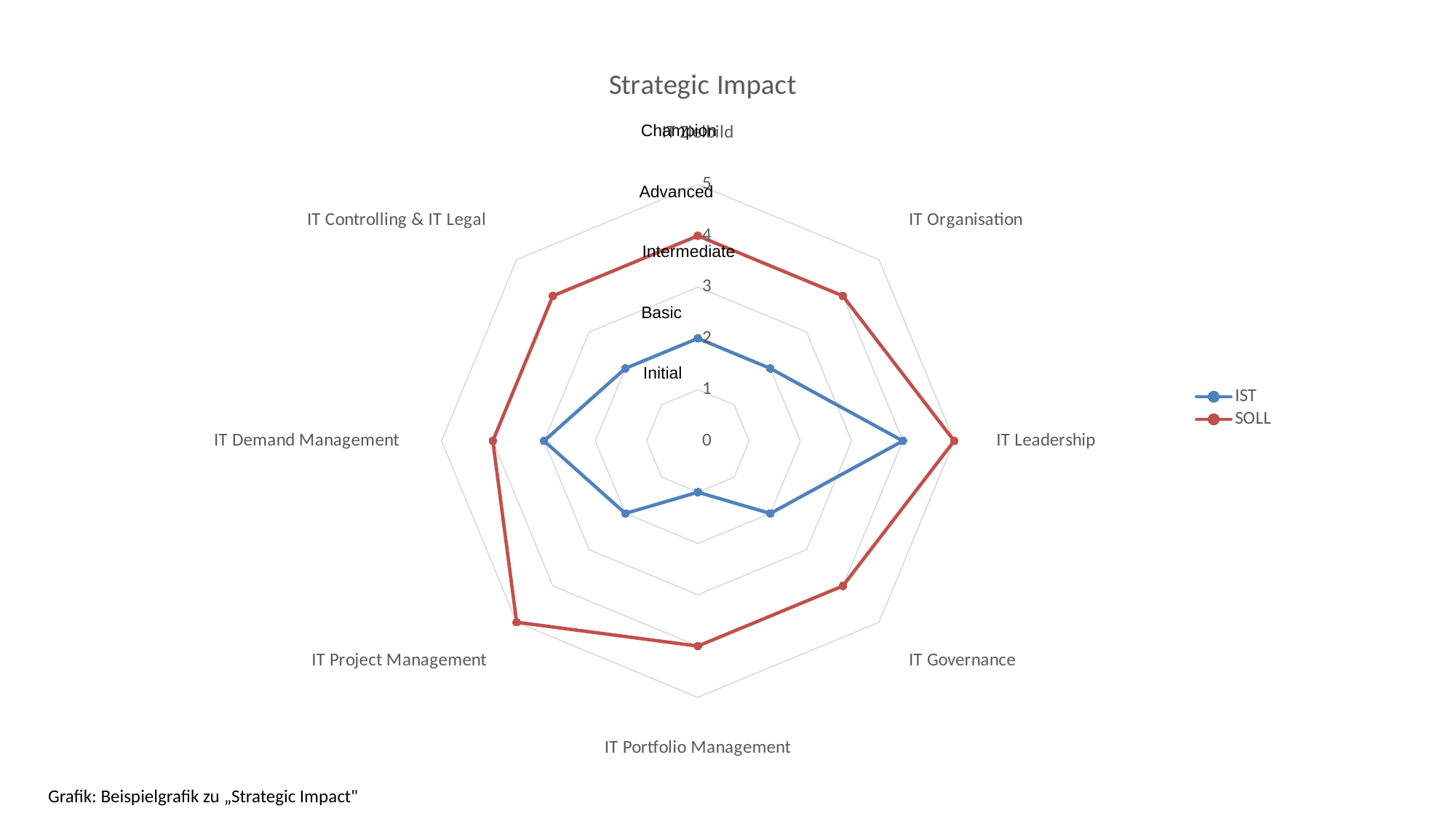
How many series does the legend list? 2 What kind of chart is shown on the slide? Radar chart What is the SOLL value for IT Zielbild? 4 Is the SOLL value for IT Project Management greater or less than 3? greater What is the IST value for IT Zielbild? 2 For IT Leadership, which series has the larger value, IST or SOLL? SOLL Which colour is used for the SOLL series? Red How many categories (axes) does the radar chart have? 8 What is the title of the chart? Strategic Impact For which category is the IST value highest? IT Leadership For which category is the IST value lowest? IT Portfolio Management What is the IST value for IT Leadership? 4